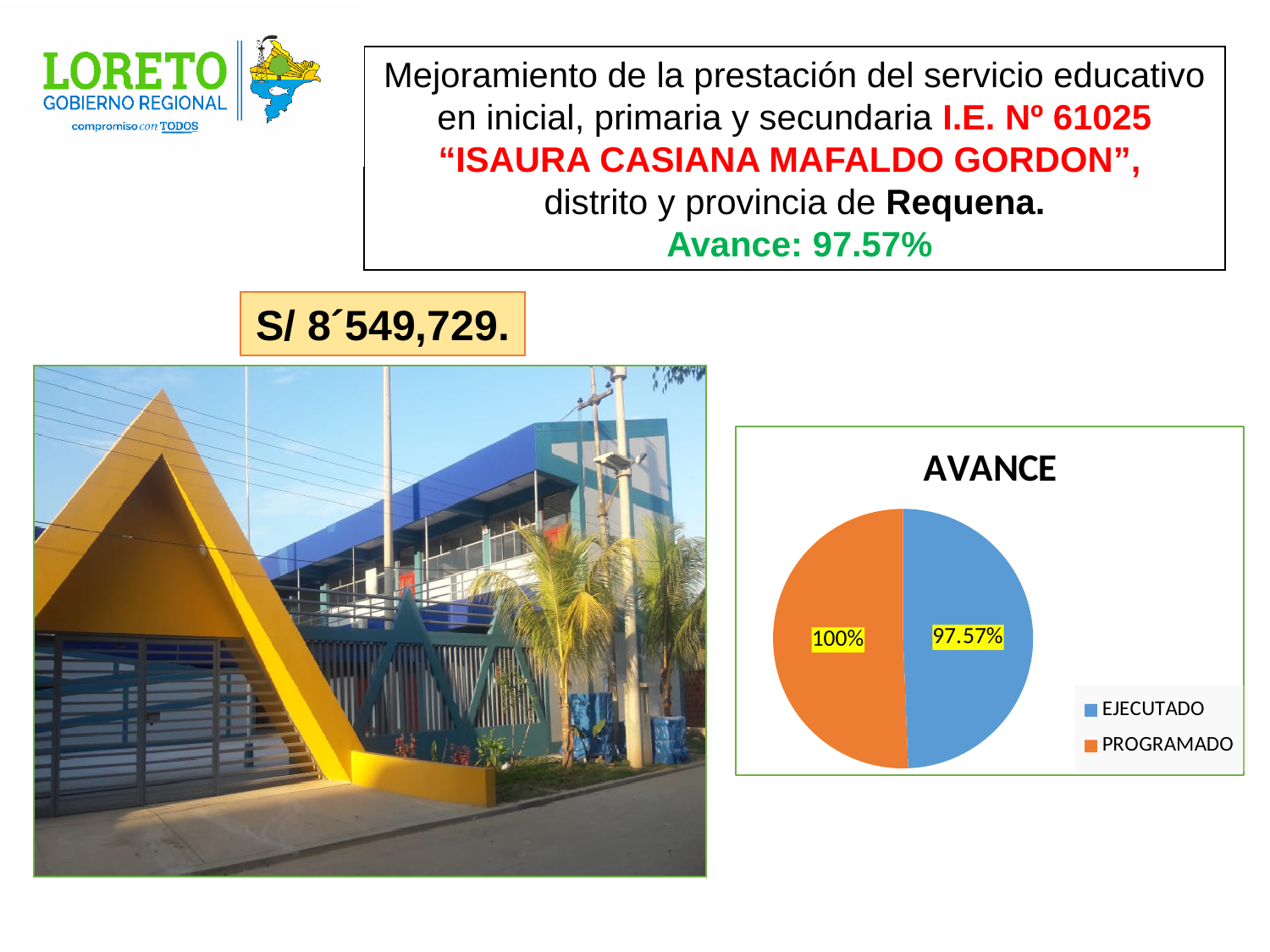
How many slices does the AVANCE pie chart have? 2 Which slice has the higher labelled value, EJECUTADO or PROGRAMADO? PROGRAMADO What value is shown for EJECUTADO in the AVANCE pie chart? 97.57% Which category has the lowest labelled value in the AVANCE chart? EJECUTADO How many entries does the legend of the AVANCE chart list? 2 What colour is the EJECUTADO slice in the AVANCE pie chart? blue Which category has the highest labelled value in the AVANCE chart? PROGRAMADO What is the difference between the labelled values for PROGRAMADO and EJECUTADO? 2.43% What is the title of the chart? AVANCE Is the labelled value for EJECUTADO greater or less than 90%? greater What value is shown for PROGRAMADO in the AVANCE pie chart? 100% What kind of chart is shown on the slide? pie chart